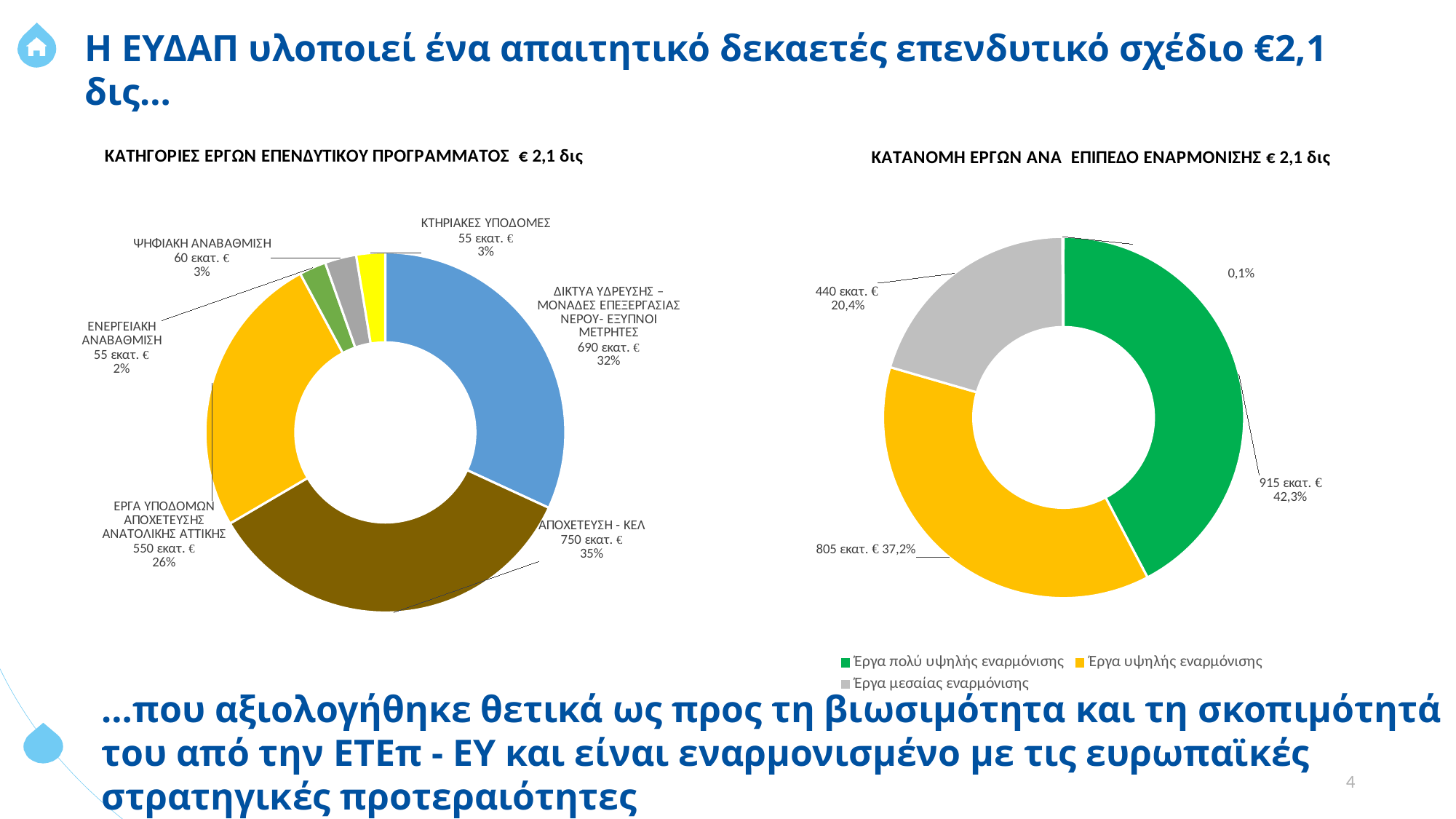
In the chart titled ΚΑΤΗΓΟΡΙΕΣ ΕΡΓΩΝ ΕΠΕΝΔΥΤΙΚΟΥ ΠΡΟΓΡΑΜΜΑΤΟΣ, which category has the largest value? ΑΠΟΧΕΤΕΥΣΗ - ΚΕΛ In the chart titled ΚΑΤΗΓΟΡΙΕΣ ΕΡΓΩΝ ΕΠΕΝΔΥΤΙΚΟΥ ΠΡΟΓΡΑΜΜΑΤΟΣ, what is the difference in value between ΑΠΟΧΕΤΕΥΣΗ - ΚΕΛ and ΔΙΚΤΥΑ ΥΔΡΕΥΣΗΣ – ΜΟΝΑΔΕΣ ΕΠΕΞΕΡΓΑΣΙΑΣ ΝΕΡΟΥ- ΕΞΥΠΝΟΙ ΜΕΤΡΗΤΕΣ? 60 εκατ. € In the chart titled ΚΑΤΗΓΟΡΙΕΣ ΕΡΓΩΝ ΕΠΕΝΔΥΤΙΚΟΥ ΠΡΟΓΡΑΜΜΑΤΟΣ, what percentage share is shown for ΕΡΓΑ ΥΠΟΔΟΜΩΝ ΑΠΟΧΕΤΕΥΣΗΣ ΑΝΑΤΟΛΙΚΗΣ ΑΤΤΙΚΗΣ? 26% How many entries does the legend list in the chart titled ΚΑΤΑΝΟΜΗ ΕΡΓΩΝ ΑΝΑ ΕΠΙΠΕΔΟ ΕΝΑΡΜΟΝΙΣΗΣ? 3 In the chart titled ΚΑΤΑΝΟΜΗ ΕΡΓΩΝ ΑΝΑ ΕΠΙΠΕΔΟ ΕΝΑΡΜΟΝΙΣΗΣ, what percentage share is shown for Έργα μεσαίας εναρμόνισης? 20,4% What kind of chart is the chart titled ΚΑΤΗΓΟΡΙΕΣ ΕΡΓΩΝ ΕΠΕΝΔΥΤΙΚΟΥ ΠΡΟΓΡΑΜΜΑΤΟΣ? Donut (pie) chart In the chart titled ΚΑΤΗΓΟΡΙΕΣ ΕΡΓΩΝ ΕΠΕΝΔΥΤΙΚΟΥ ΠΡΟΓΡΑΜΜΑΤΟΣ, what is the value for ΑΠΟΧΕΤΕΥΣΗ - ΚΕΛ? 750 εκατ. € How many categories are shown in the chart titled ΚΑΤΗΓΟΡΙΕΣ ΕΡΓΩΝ ΕΠΕΝΔΥΤΙΚΟΥ ΠΡΟΓΡΑΜΜΑΤΟΣ? 6 In the chart titled ΚΑΤΗΓΟΡΙΕΣ ΕΡΓΩΝ ΕΠΕΝΔΥΤΙΚΟΥ ΠΡΟΓΡΑΜΜΑΤΟΣ, which is larger: ΨΗΦΙΑΚΗ ΑΝΑΒΑΘΜΙΣΗ or ΕΝΕΡΓΕΙΑΚΗ ΑΝΑΒΑΘΜΙΣΗ? ΨΗΦΙΑΚΗ ΑΝΑΒΑΘΜΙΣΗ In the chart titled ΚΑΤΑΝΟΜΗ ΕΡΓΩΝ ΑΝΑ ΕΠΙΠΕΔΟ ΕΝΑΡΜΟΝΙΣΗΣ, what colour represents Έργα υψηλής εναρμόνισης? Yellow In the chart titled ΚΑΤΑΝΟΜΗ ΕΡΓΩΝ ΑΝΑ ΕΠΙΠΕΔΟ ΕΝΑΡΜΟΝΙΣΗΣ, what is the value for Έργα πολύ υψηλής εναρμόνισης? 915 εκατ. € In the chart titled ΚΑΤΑΝΟΜΗ ΕΡΓΩΝ ΑΝΑ ΕΠΙΠΕΔΟ ΕΝΑΡΜΟΝΙΣΗΣ, what is the difference in value between Έργα πολύ υψηλής εναρμόνισης and Έργα υψηλής εναρμόνισης? 110 εκατ. €